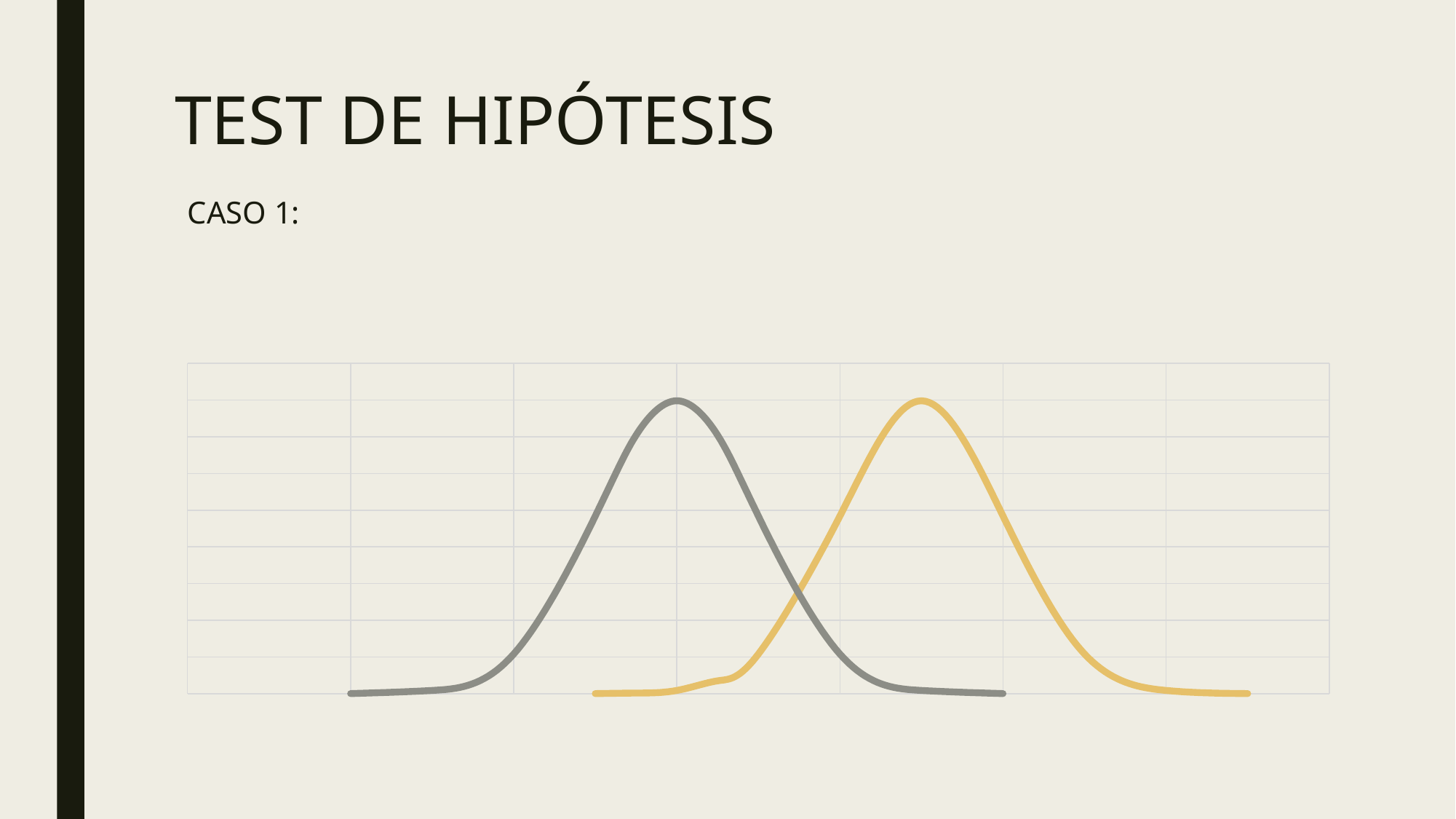
Which curve has its peak further to the right along the x axis, the gray one or the yellow one? the yellow one Which curve has its peak further to the left along the x axis, the gray one or the yellow one? the gray one What colours are the two curves on the chart? gray and yellow Does the chart display a legend? no What kind of chart is shown on the slide? line chart How many curves are plotted on the chart? 2